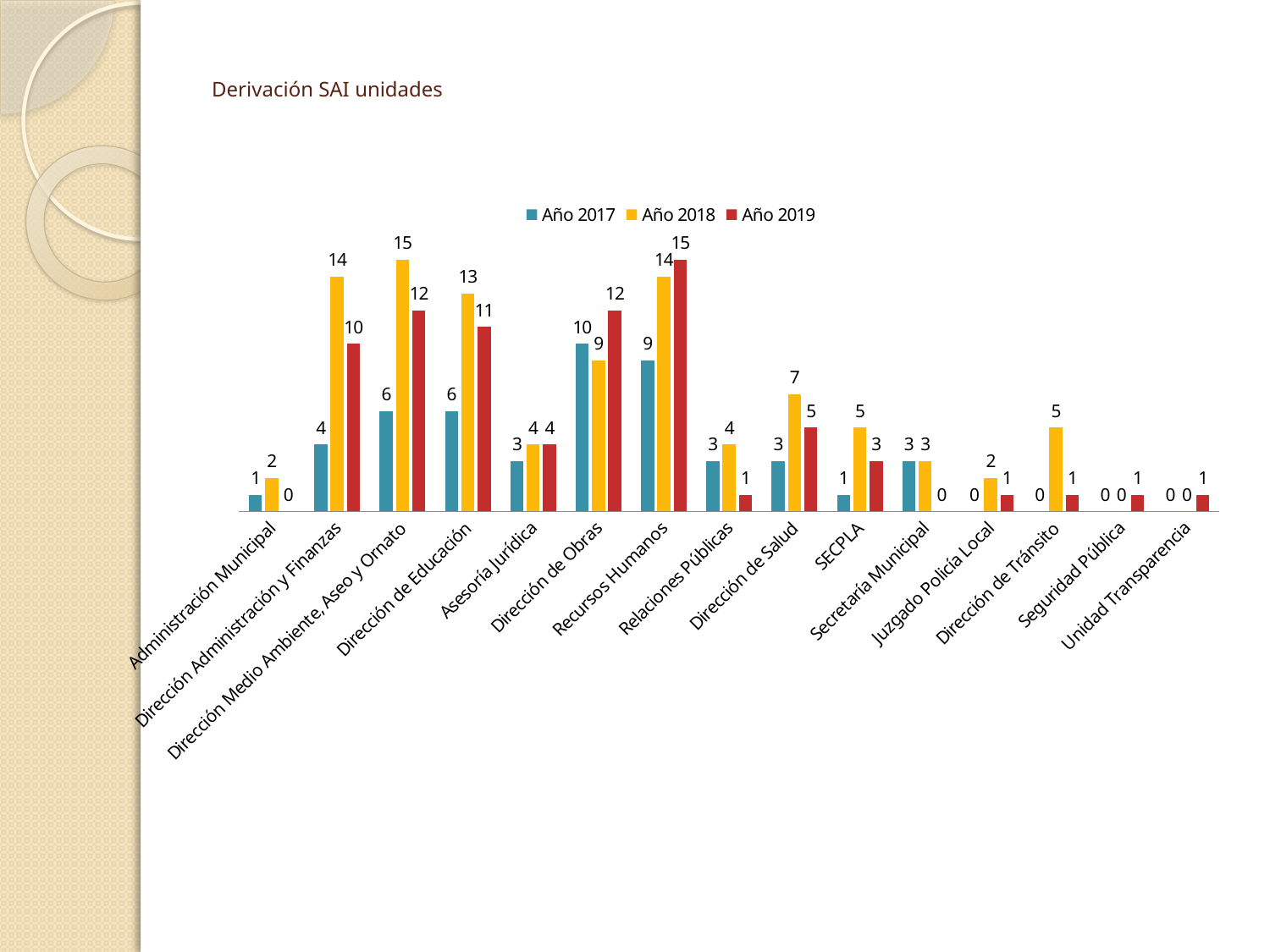
What is the value for Año 2018 for Dirección de Educación? 13 Which is larger for Dirección de Salud: the Año 2018 value or the Año 2019 value? Año 2018 Which category has the highest value for Año 2018? Dirección Medio Ambiente, Aseo y Ornato What is the difference between the Año 2018 and Año 2017 values for Dirección Administración y Finanzas? 10 What kind of chart is shown on the slide? Bar chart How many series does the legend list? 3 What is the title of the chart? Derivación SAI unidades Which category has the highest value for Año 2017? Dirección de Obras What is the value for Año 2017 for Recursos Humanos? 9 What is the value for Año 2019 for Dirección de Obras? 12 How many categories are shown on the x axis? 15 What is the value for Año 2019 for Secretaría Municipal? 0